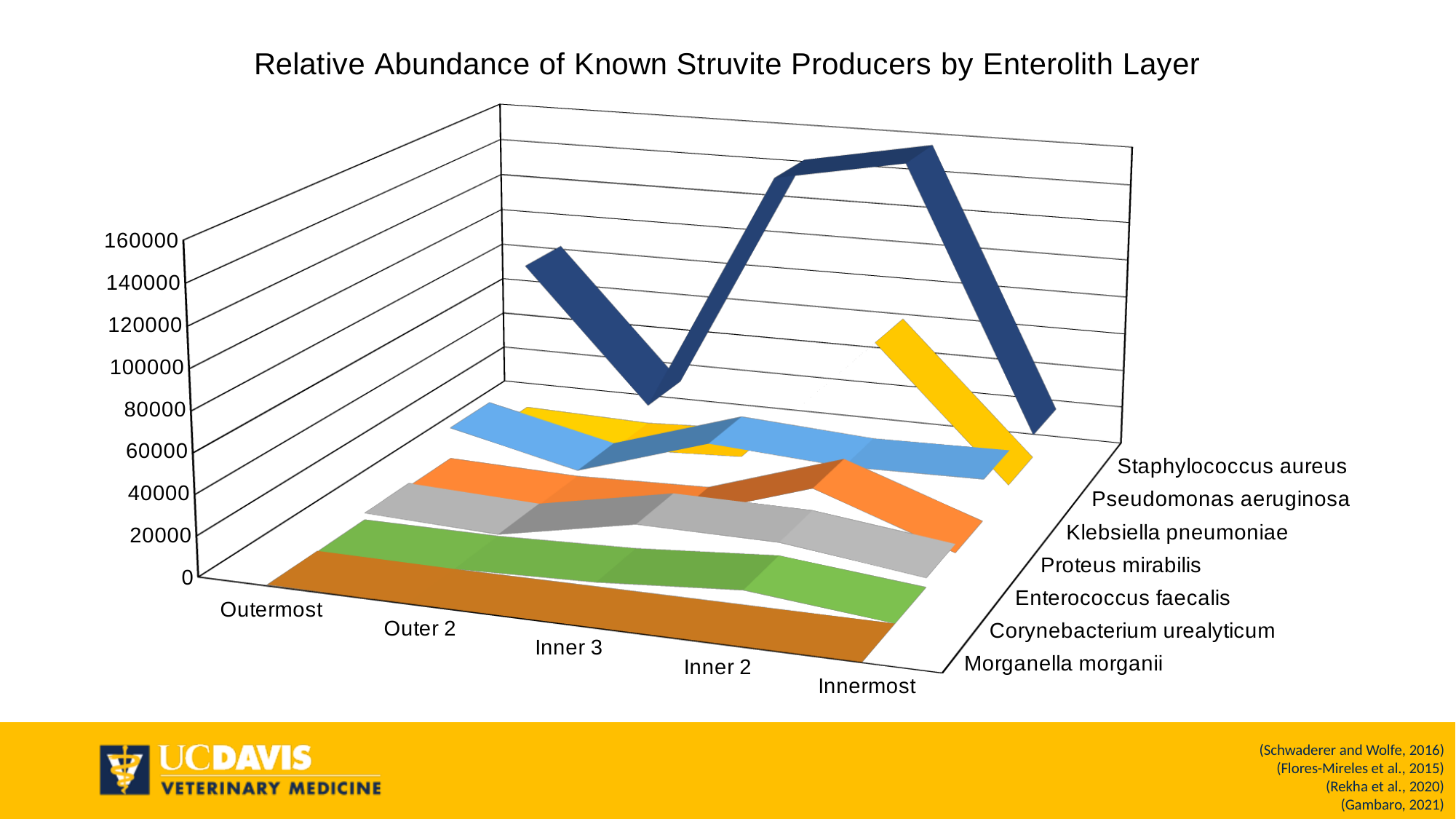
Is the value for Staphylococcus aureus at Inner 2 greater or less than 120000? greater Does the Staphylococcus aureus line rise or fall from Inner 3 to Inner 2? rise How many enterolith layers are shown along the x axis? 5 What is the title of the chart? Relative Abundance of Known Struvite Producers by Enterolith Layer Does the Pseudomonas aeruginosa line rise or fall from Inner 2 to Innermost? fall How many organisms (series) are plotted in the chart? 7 Which organism reaches the highest relative abundance in the chart? Staphylococcus aureus What kind of chart is shown on the slide? line chart For Staphylococcus aureus, which layer has the highest relative abundance? Inner 2 Does the Staphylococcus aureus line rise or fall from Inner 2 to Innermost? fall What colour is the Staphylococcus aureus line? dark blue For Staphylococcus aureus, is the value at Inner 2 larger or smaller than the value at Outermost? larger